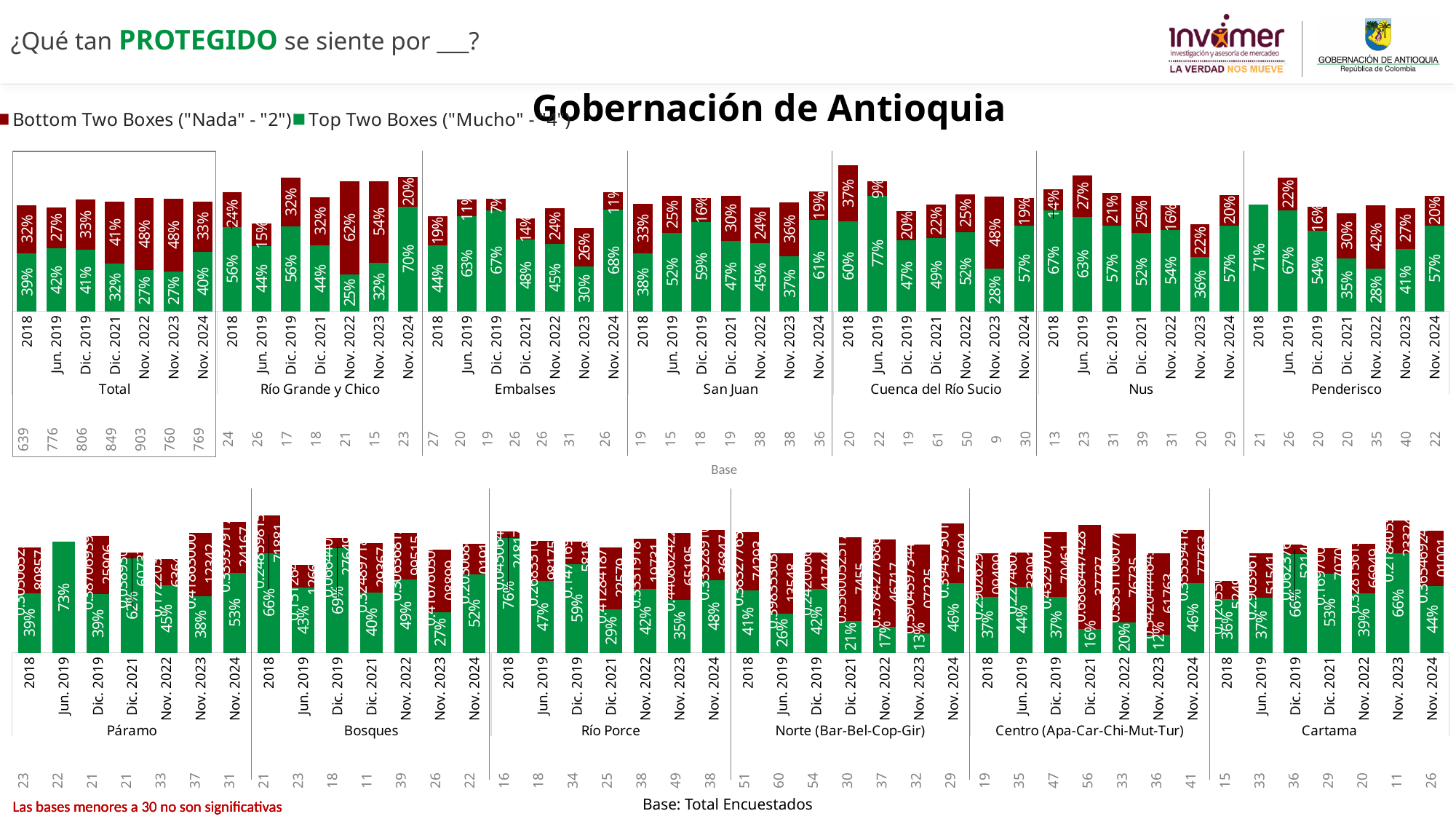
How many series does the legend list? 2 In the top chart, which period has the lowest Top Two Boxes value for Total? Nov. 2022 and Nov. 2023 (27%) What kind of chart is used on this slide? Stacked bar chart In the bottom chart, which period has the lowest Top Two Boxes value for Centro (Apa-Car-Chi-Mut-Tur)? Nov. 2023 In the top chart, what is the base (number of respondents) for Total in Nov. 2022? 903 In the top chart, what is the combined height of the stacked bar for San Juan in Nov. 2023 (Top Two Boxes plus Bottom Two Boxes)? 73% In the top chart, which period has the highest Top Two Boxes value for Cuenca del Río Sucio? Jun. 2019 In the top chart, which is larger for Nus in 2018: the Top Two Boxes value or the Bottom Two Boxes value? Top Two Boxes (67%) In the bottom chart, what is the Top Two Boxes value for Río Porce in 2018? 76% In the top chart, what is the difference between the Top Two Boxes and Bottom Two Boxes values for Embalses in Nov. 2024? 57 percentage points In the top chart, what is the Bottom Two Boxes value for Río Grande y Chico in Nov. 2022? 62% In the top chart, what is the Top Two Boxes value for Total in Nov. 2024? 40%